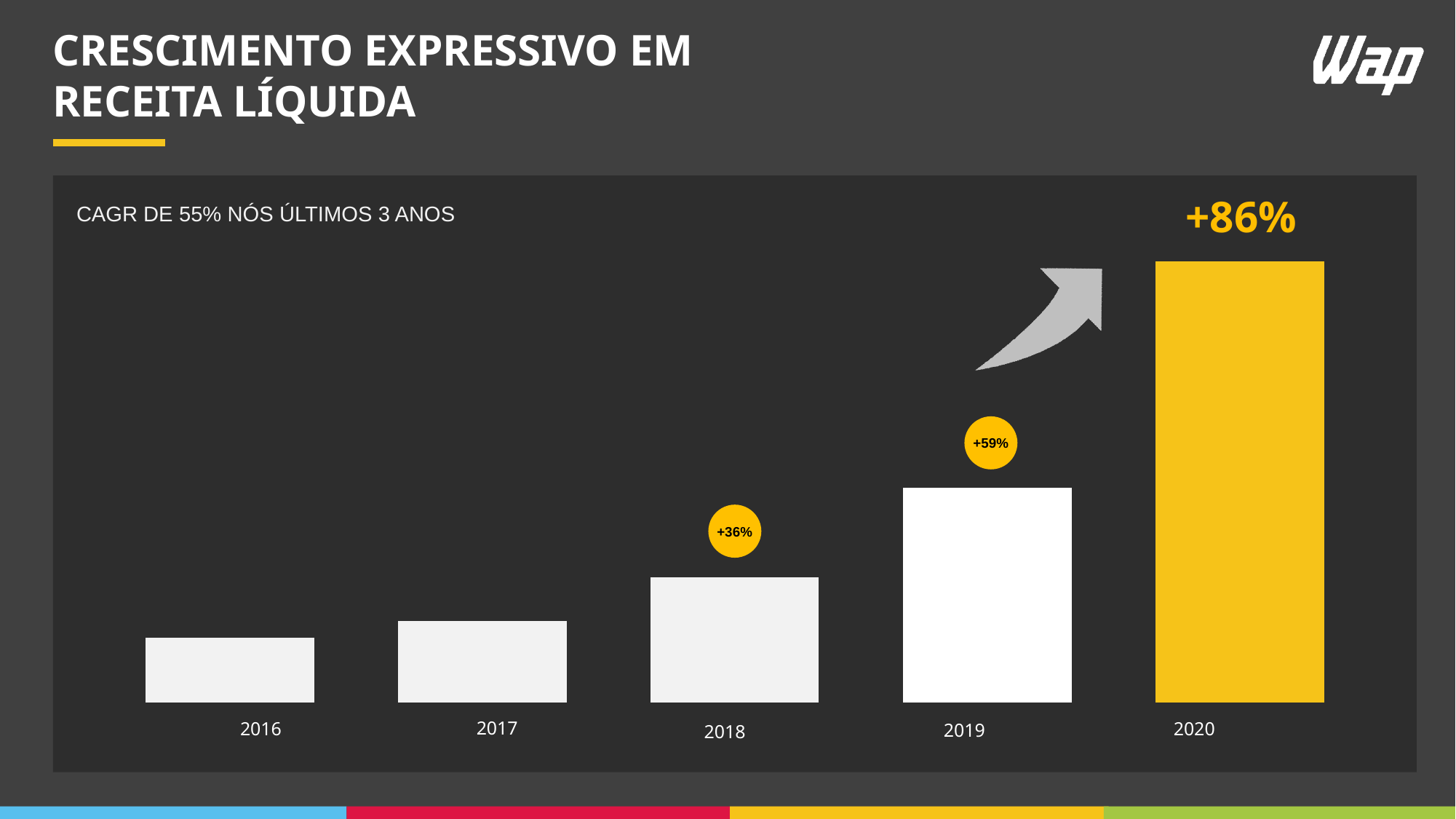
What colour is the 2020 bar? yellow Which year has the shortest bar in the chart? 2016 Do the bar values rise or fall from 2016 to 2020? rise What kind of chart is shown on the slide? bar chart Which year has the tallest bar in the chart? 2020 How many years (bars) are shown in the chart? 5 What growth percentage is labelled above the 2018 bar? +36% What growth percentage is labelled above the 2020 bar? +86% Which bar is taller, 2016 or 2017? 2017 What growth percentage is labelled above the 2019 bar? +59% Which bar is taller, 2019 or 2018? 2019 What CAGR over the last 3 years is stated on the chart? 55%